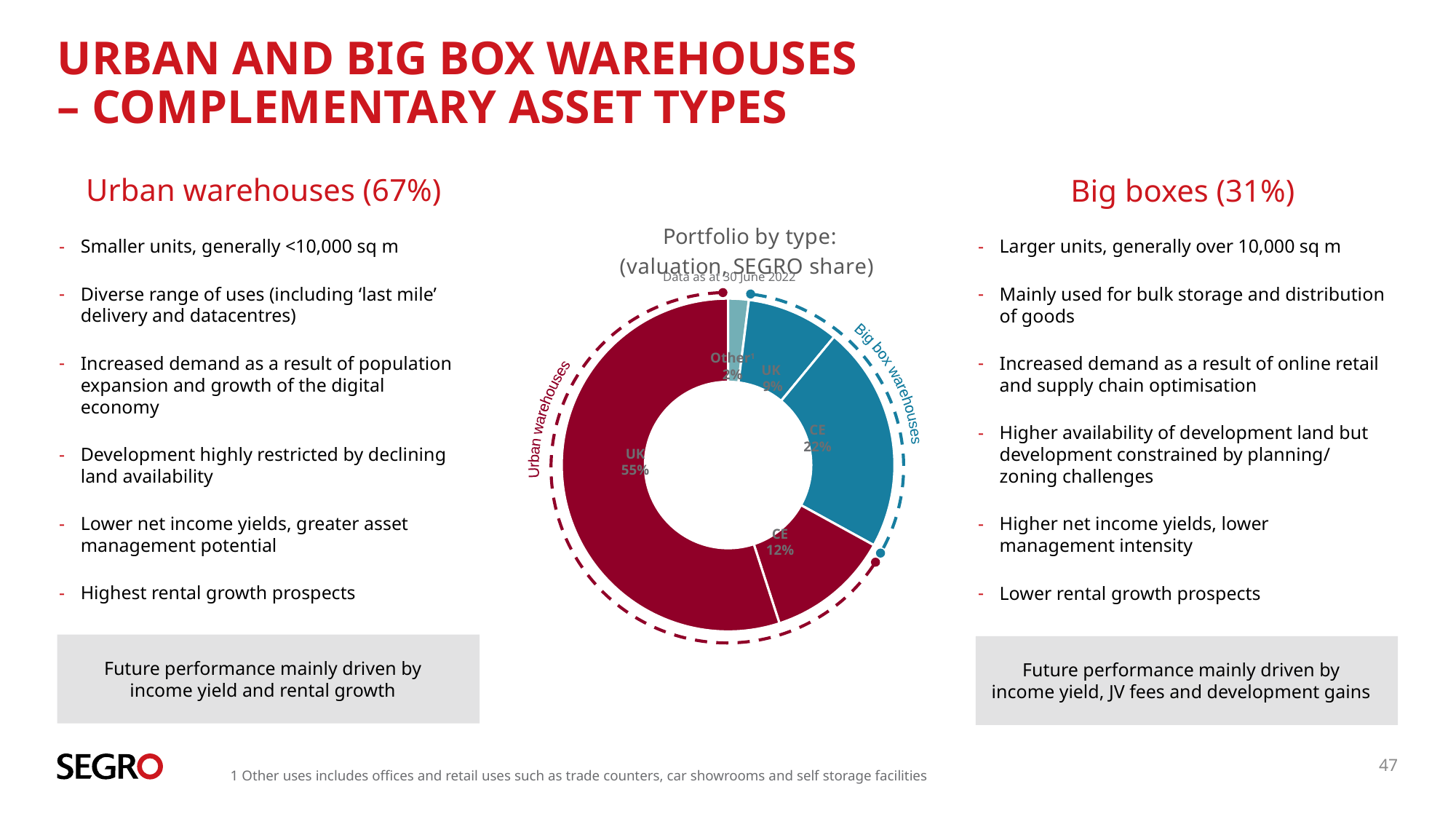
Which is larger: the CE urban warehouses segment or the UK big box segment? CE urban warehouses Which segment of the chart is the smallest? Other (2%) What share of the portfolio is CE big box warehouses? 22% What is the title of the chart? Portfolio by type: (valuation, SEGRO share) What share of the portfolio is labelled Other? 2% What share of the portfolio is UK big box warehouses? 9% How many segments does the chart have? 5 What kind of chart is shown in the centre of the slide? Pie (donut) chart How many percentage points larger is the UK urban warehouses segment than the CE big box segment? 33 percentage points What share of the portfolio is UK urban warehouses? 55% Which segment of the chart is the largest? UK urban warehouses (55%) What share of the portfolio is CE urban warehouses? 12%